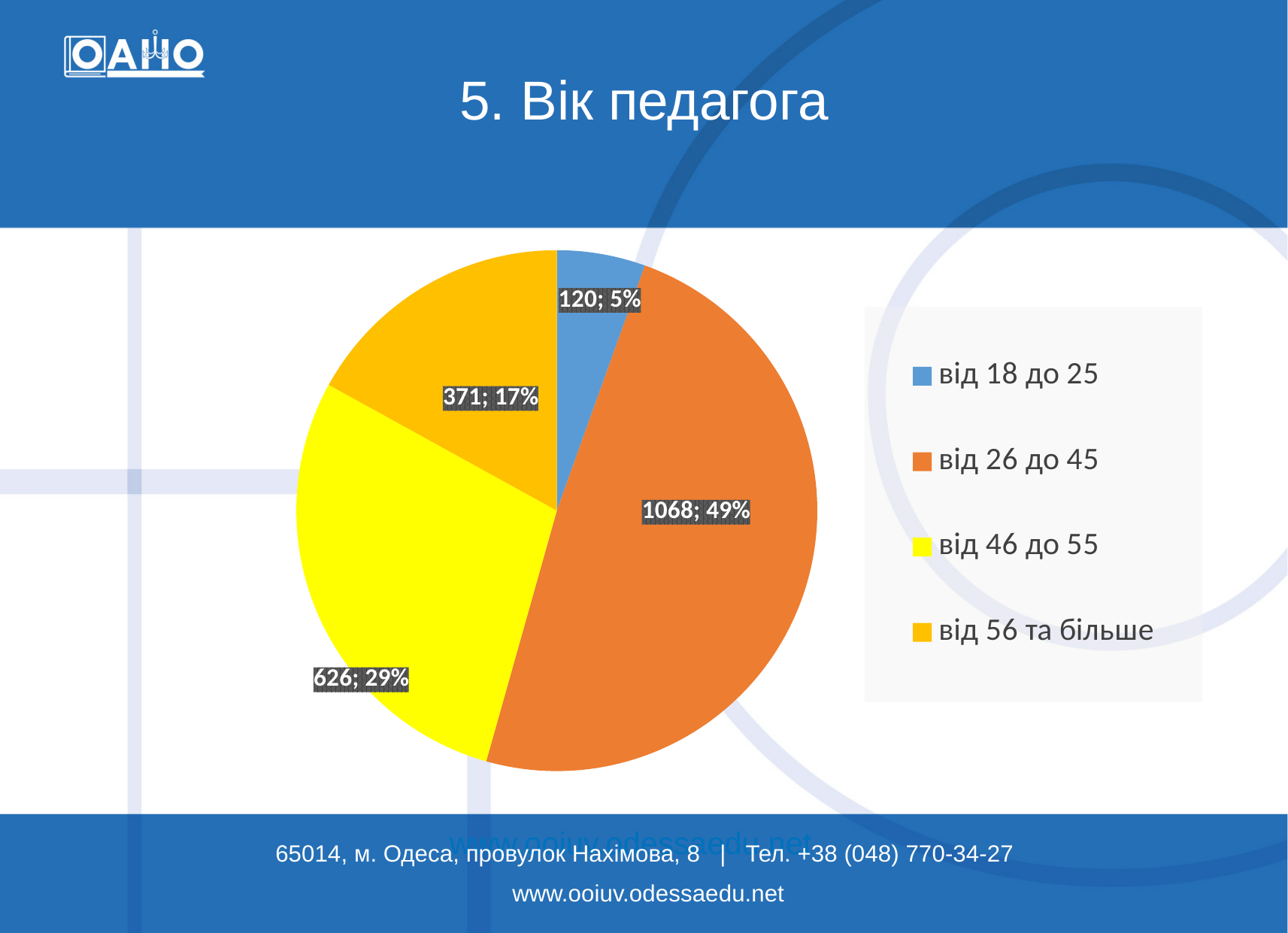
What is the value for the category "від 18 до 25"? 120 Which category has the largest slice? від 26 до 45 How many slices does the pie chart have? 4 What share of the pie does the category "від 26 до 45" represent? 49% Which is larger, the value for "від 46 до 55" or the value for "від 56 та більше"? від 46 до 55 What is the value for the category "від 26 до 45"? 1068 What share of the pie does the category "від 46 до 55" represent? 29% What is the title of the slide containing the chart? 5. Вік педагога What kind of chart is shown on the slide? pie chart Which category has the smallest slice? від 18 до 25 What is the value for the category "від 56 та більше"? 371 What is the difference between the values for "від 46 до 55" and "від 56 та більше"? 255